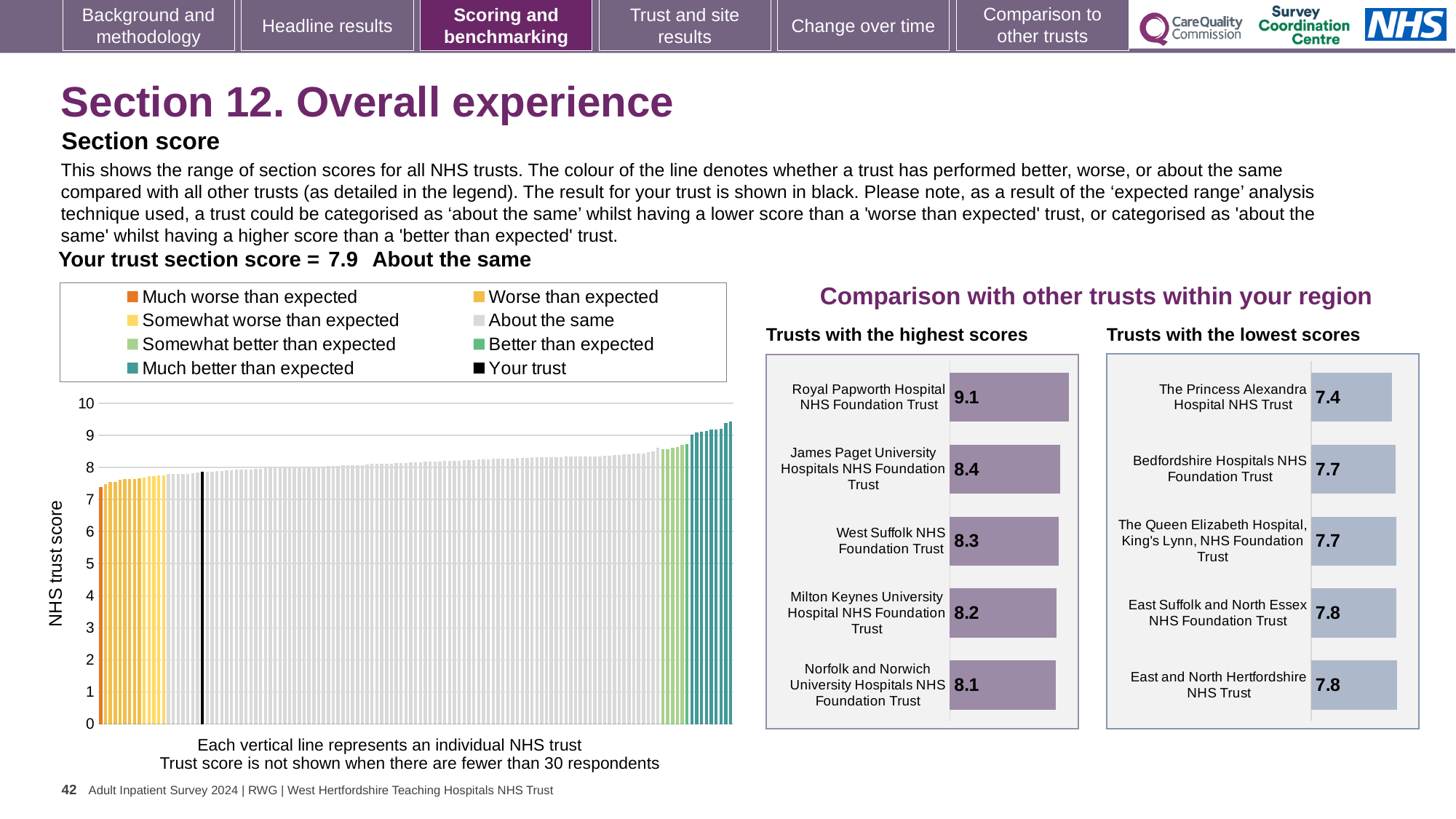
In the 'Trusts with the lowest scores' chart, which has the larger score: Bedfordshire Hospitals NHS Foundation Trust or East and North Hertfordshire NHS Trust? East and North Hertfordshire NHS Trust In the large 'NHS trust score' chart on the left, is the value of the tallest bar greater or less than 9? greater In the 'Trusts with the lowest scores' chart, what is the score for East Suffolk and North Essex NHS Foundation Trust? 7.8 What kind of chart is the large 'NHS trust score' chart on the left? Bar chart In the large 'NHS trust score' chart on the left, do the values rise or fall from left to right along the x axis? Rise In the 'Trusts with the highest scores' chart, what is the difference between the scores of Royal Papworth Hospital NHS Foundation Trust and James Paget University Hospitals NHS Foundation Trust? 0.7 In the 'Trusts with the highest scores' chart, which trust has the highest score? Royal Papworth Hospital NHS Foundation Trust In the 'Trusts with the highest scores' chart, how many trusts are shown? 5 In the 'Trusts with the lowest scores' chart, which trust has the lowest score? The Princess Alexandra Hospital NHS Trust In the 'Trusts with the lowest scores' chart, what is the score for The Princess Alexandra Hospital NHS Trust? 7.4 In the 'Trusts with the highest scores' chart, what is the score for Royal Papworth Hospital NHS Foundation Trust? 9.1 In the large 'NHS trust score' chart on the left, how many entries does the legend list? 8